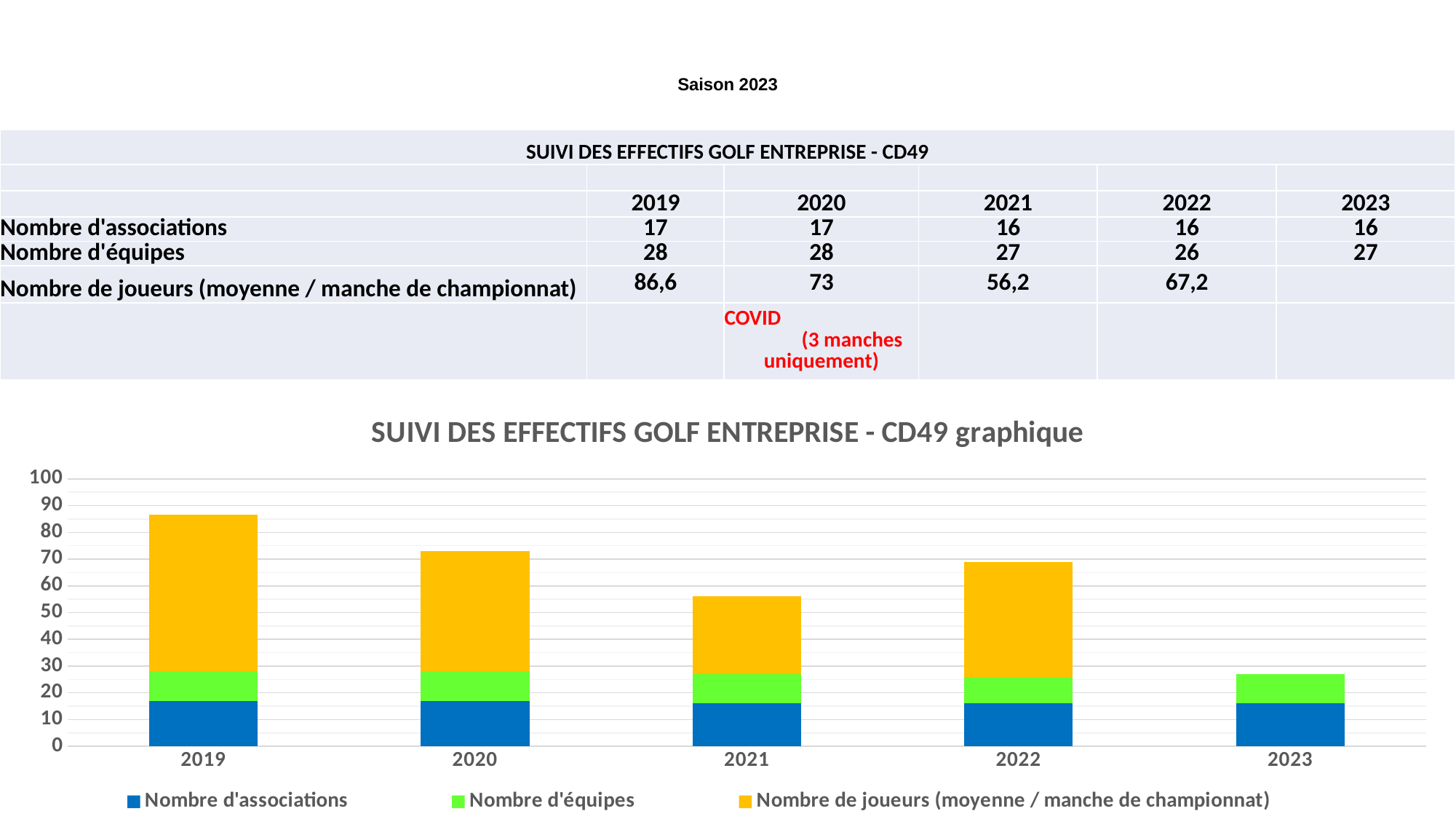
Is the value for 'Nombre de joueurs (moyenne / manche de championnat)' in 2019 greater or less than 80? greater What kind of chart is shown on the slide? bar chart Among the years where it is plotted, in which year is 'Nombre de joueurs (moyenne / manche de championnat)' lowest? 2021 What is the difference in 'Nombre de joueurs (moyenne / manche de championnat)' between 2019 and 2020? 13,6 In which year is 'Nombre de joueurs (moyenne / manche de championnat)' highest? 2019 What is the value of 'Nombre de joueurs (moyenne / manche de championnat)' for 2021? 56,2 How many series does the chart legend list? 3 What is the value of 'Nombre d'associations' for 2023? 16 What is the title of the chart? SUIVI DES EFFECTIFS GOLF ENTREPRISE - CD49 graphique What is the value of 'Nombre d'équipes' for 2022? 26 How many years (categories) are shown on the x axis of the chart? 5 Which year has the larger 'Nombre de joueurs (moyenne / manche de championnat)', 2020 or 2022? 2020